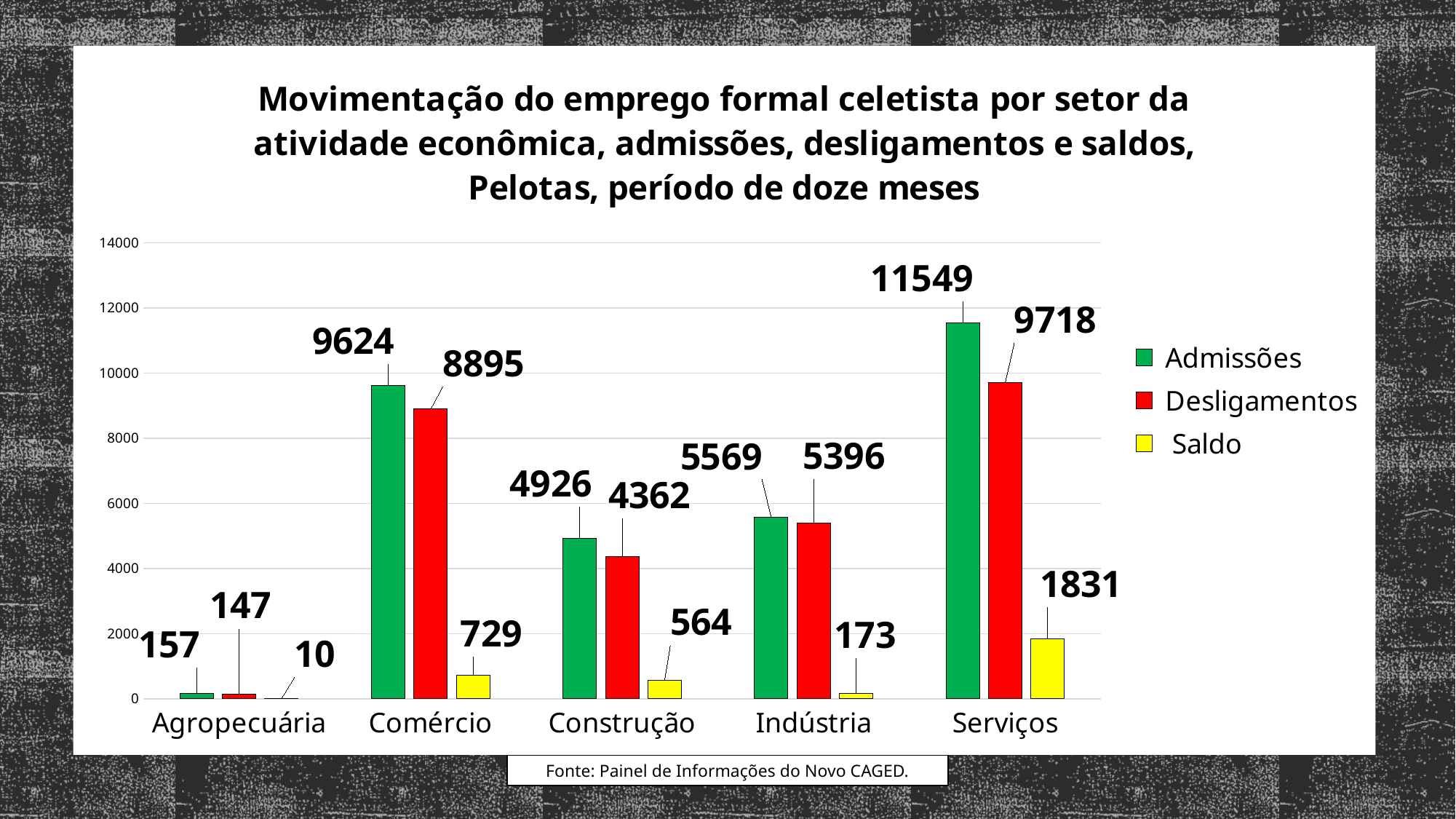
What kind of chart is shown on the slide? bar chart Is the Desligamentos value for Serviços greater or less than 8000? greater What is the Desligamentos value for Comércio? 8895 How many sectors are shown on the x axis? 5 What is the Saldo value for Indústria? 173 Which sector has the lowest Saldo value? Agropecuária What is the difference between Admissões and Desligamentos for Construção? 564 What colour represents the Saldo series in the legend? yellow What is the Admissões value for Serviços? 11549 Which is larger for Indústria, Admissões or Desligamentos? Admissões How many series does the legend list? 3 Which sector has the highest Admissões value? Serviços